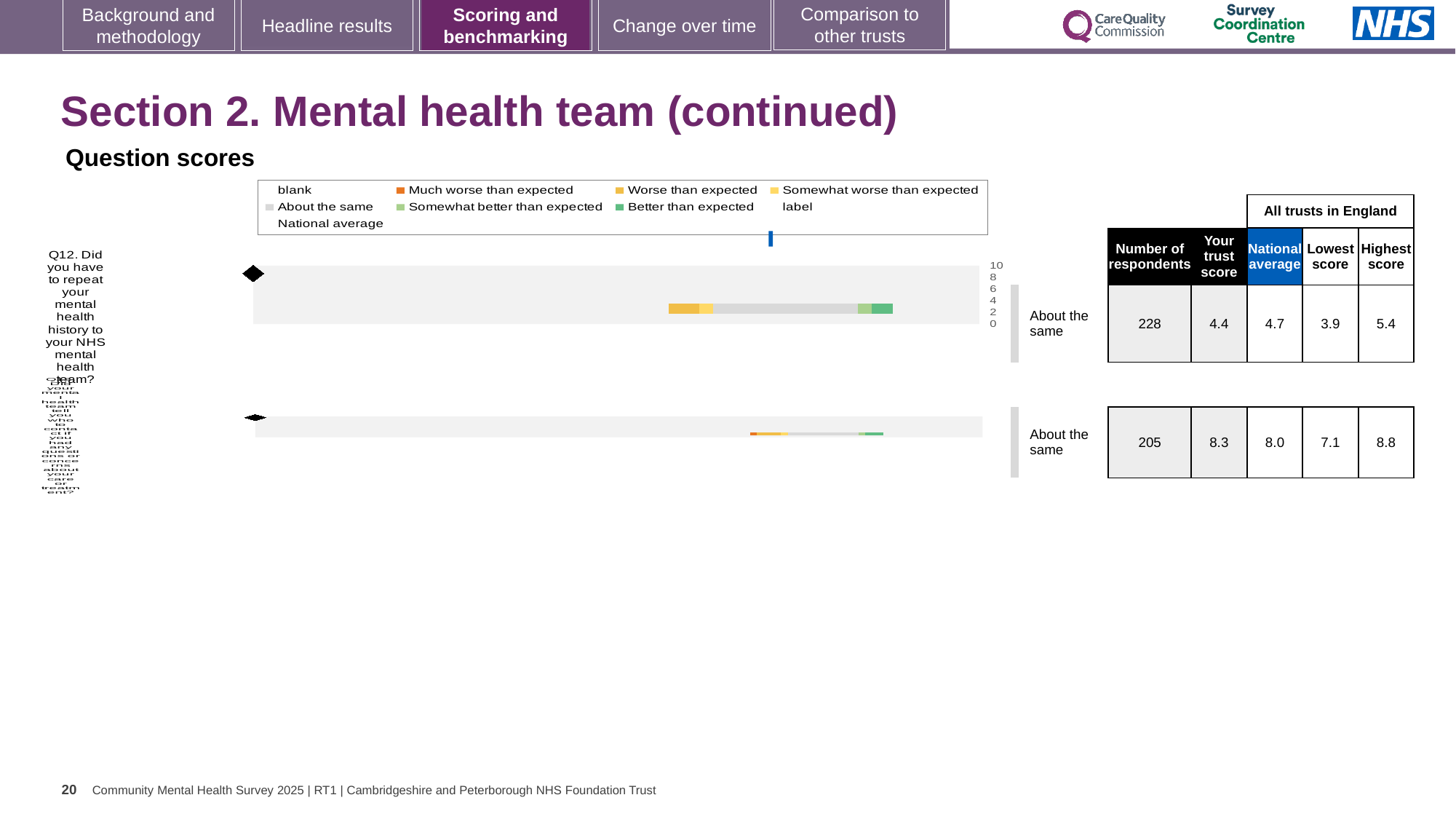
How many questions (rows) are plotted in the question scores chart? 2 What kind of chart is used to show the question scores on this slide? bar chart What benchmark category is shown next to the Q12 bar? About the same For the second (lower) question row, how much higher is the trust score than the national average? 0.3 For Q12, which is larger: the trust score or the national average? national average What is the national average score for Q12? 4.7 What colour does the legend use for 'Better than expected'? green What is the trust score for the second (lower) question row in the chart? 8.3 What is the difference between the highest and lowest trust scores in England for Q12? 1.5 What is the trust score for Q12 (repeating mental health history to the NHS mental health team)? 4.4 How many respondents answered Q12? 228 What is the highest score among all trusts in England for Q12? 5.4